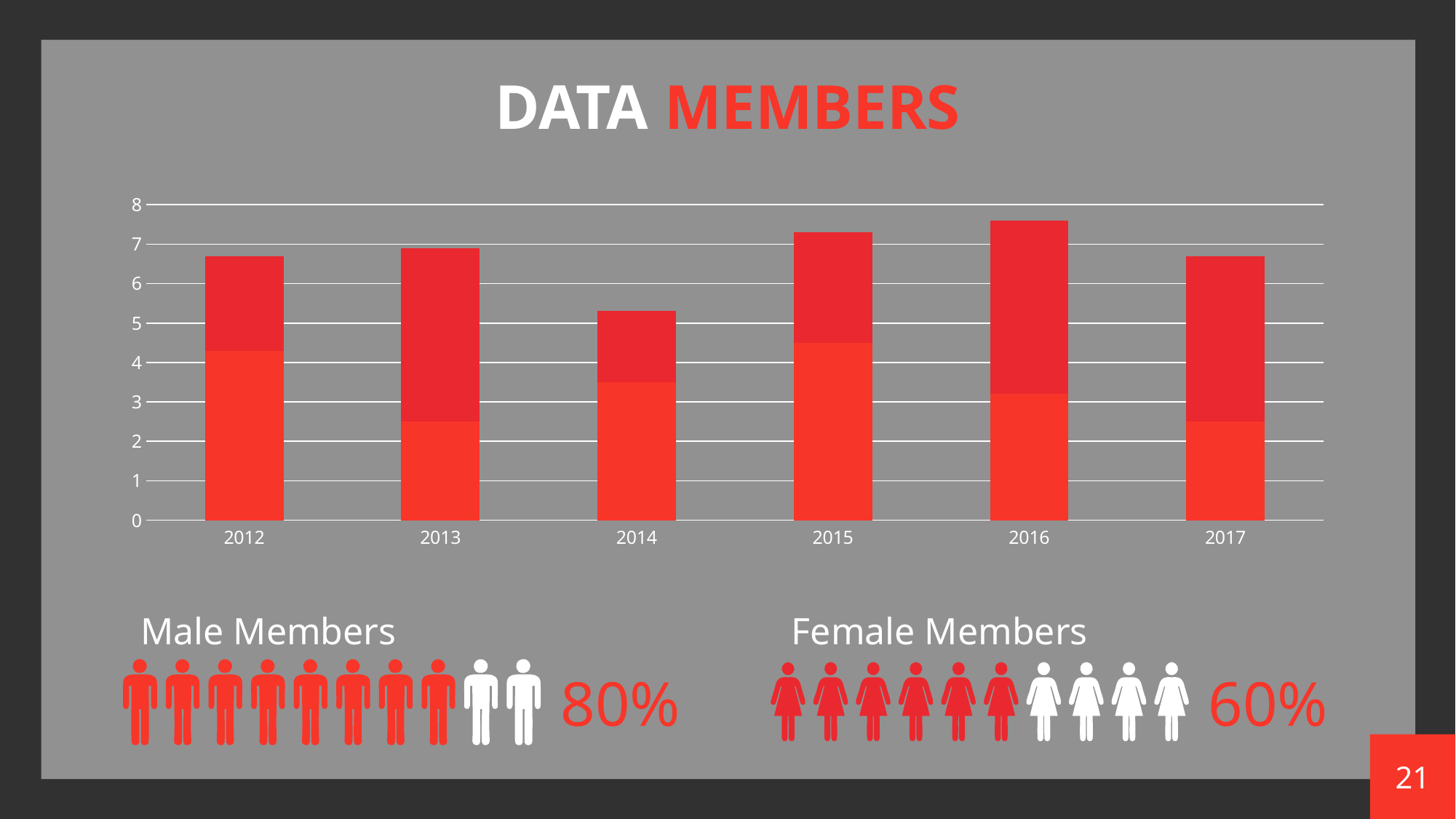
Is the total bar height for 2016 greater or less than 7? greater Which year has the tallest bar in the chart? 2016 What is the highest value shown on the chart's y axis? 8 Is the total bar height for 2015 greater or less than 7? greater What is the title of the slide containing the chart? DATA MEMBERS Do the bar totals rise or fall from 2014 to 2016? rise Is the total bar height for 2012 greater or less than 7? less Which year has the shortest bar in the chart? 2014 What kind of chart is shown on the slide? stacked bar chart How many years are shown on the x axis of the chart? 6 Which bar is taller, 2014 or 2015? 2015